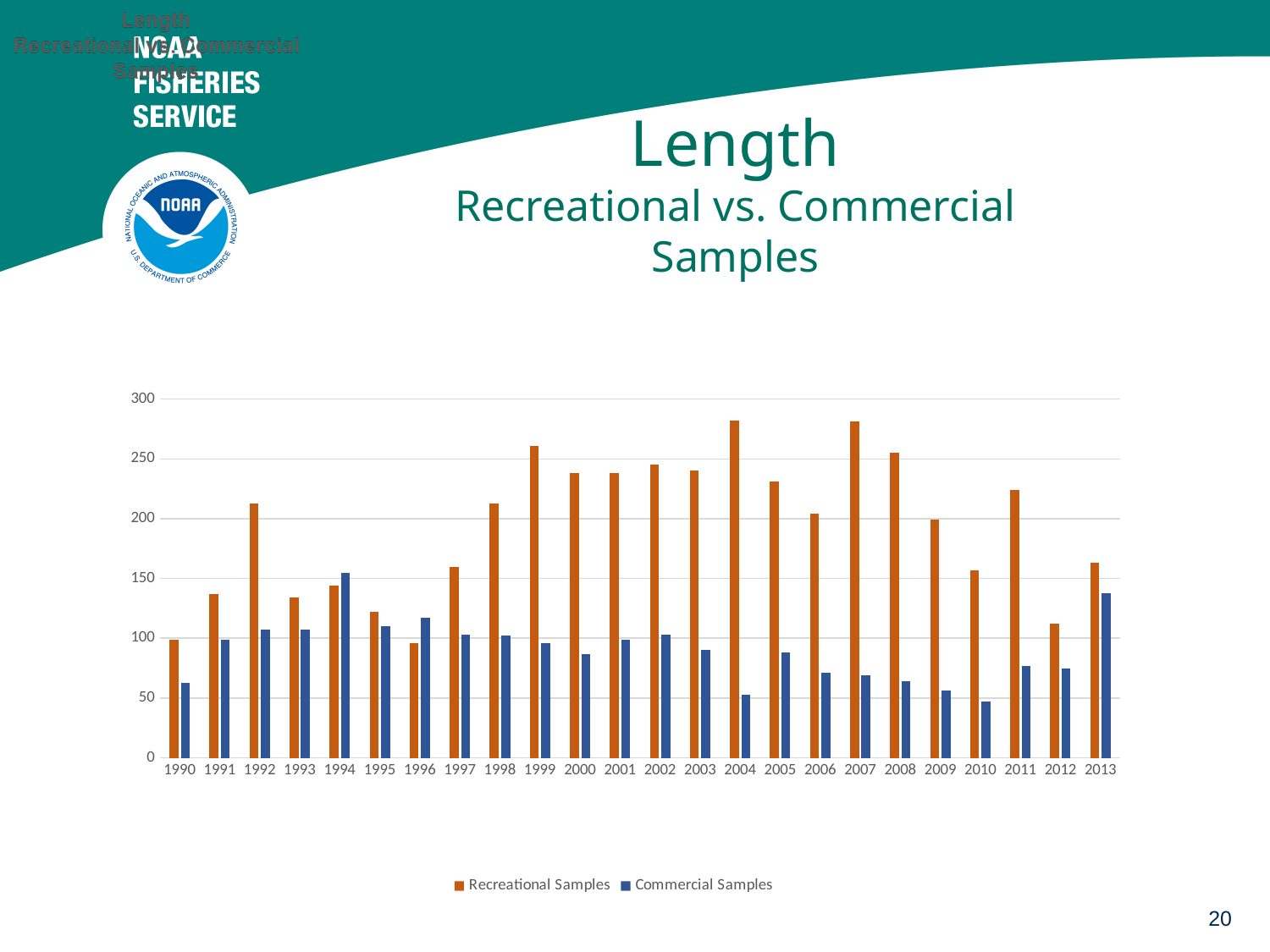
Is the value for Commercial Samples in 2013 greater or less than 100? greater Is the value for Commercial Samples in 1996 greater or less than 100? greater Is the value for Commercial Samples in 1990 greater or less than 100? less How many years are shown along the x axis? 24 In 1996, which is larger: Recreational Samples or Commercial Samples? Commercial Samples What kind of chart is shown on the slide? Bar chart Which year has the highest value for Commercial Samples? 1994 How many series does the legend list? 2 Which is larger: Recreational Samples in 2007 or Recreational Samples in 2012? 2007 Which colour represents Commercial Samples in the legend? Blue